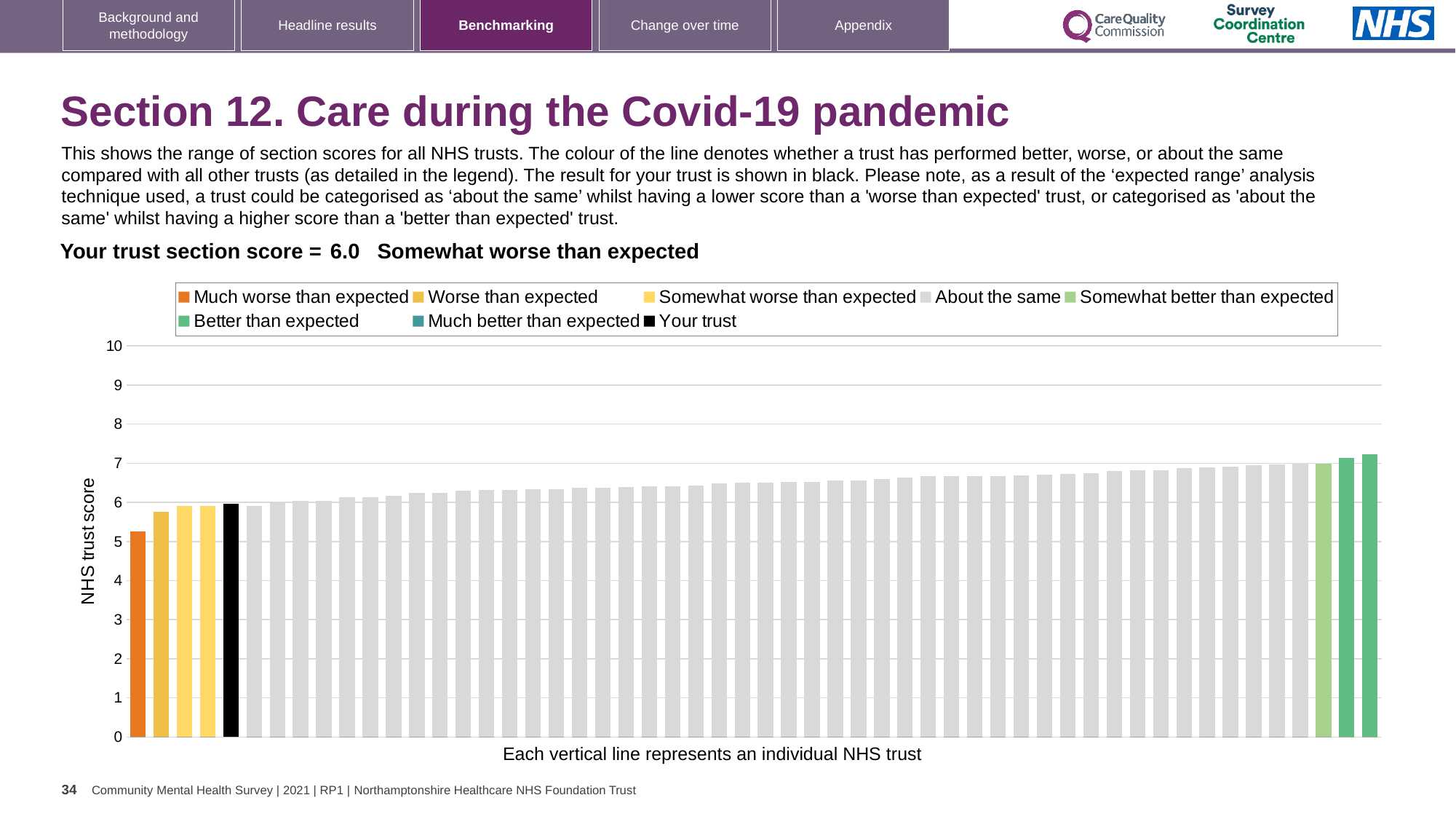
Do the bar values rise or fall from left to right along the x axis? rise What is the label on the vertical axis? NHS trust score What is the section score for your trust? 6.0 Is the value for your trust (the black bar) greater or less than 5? greater How many bars are coloured orange (Much worse than expected)? 1 Which legend category does the lowest bar belong to? Much worse than expected What colour is used for the bar representing your trust? black Is the value of the highest bar greater or less than 8? less How many entries does the chart legend list? 8 Is the value of the lowest bar (the orange bar) greater or less than 6? less What kind of chart is shown on the slide? bar chart Which performance category is your trust placed in for this section? Somewhat worse than expected